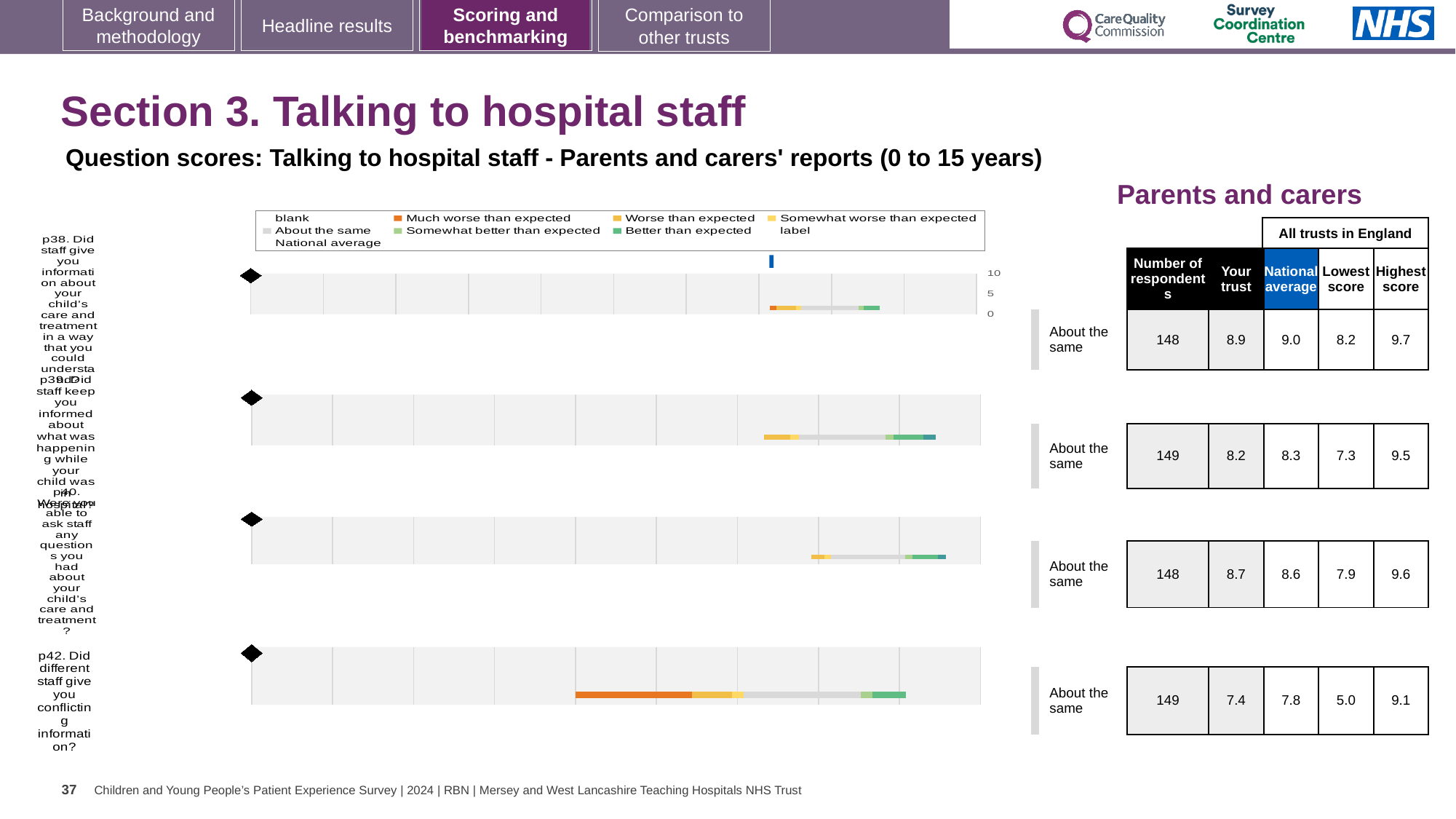
What is the highest score across all trusts in England for p39? 9.5 Which question has the highest 'Your trust' score on this slide? p38 In the table next to the charts, what is the 'Your trust' score for p38 (Did staff give you information about your child's care and treatment in a way that you could understand)? 8.9 What is the lowest score across all trusts in England for p42? 5.0 How many question charts are shown on this slide? 4 What kind of chart is used to show each question's score? Bar chart What is the national average score shown for p42 (Did different staff give you conflicting information)? 7.8 For p40, which is larger: the 'Your trust' score or the national average? Your trust What is the difference between the highest score (9.1) and the lowest score (5.0) for p42? 4.1 What benchmark category is shown for p42 (Did different staff give you conflicting information)? About the same How many respondents are listed for p39 (Did staff keep you informed about what was happening while your child was in hospital)? 149 Which question has the lowest 'Your trust' score on this slide? p42